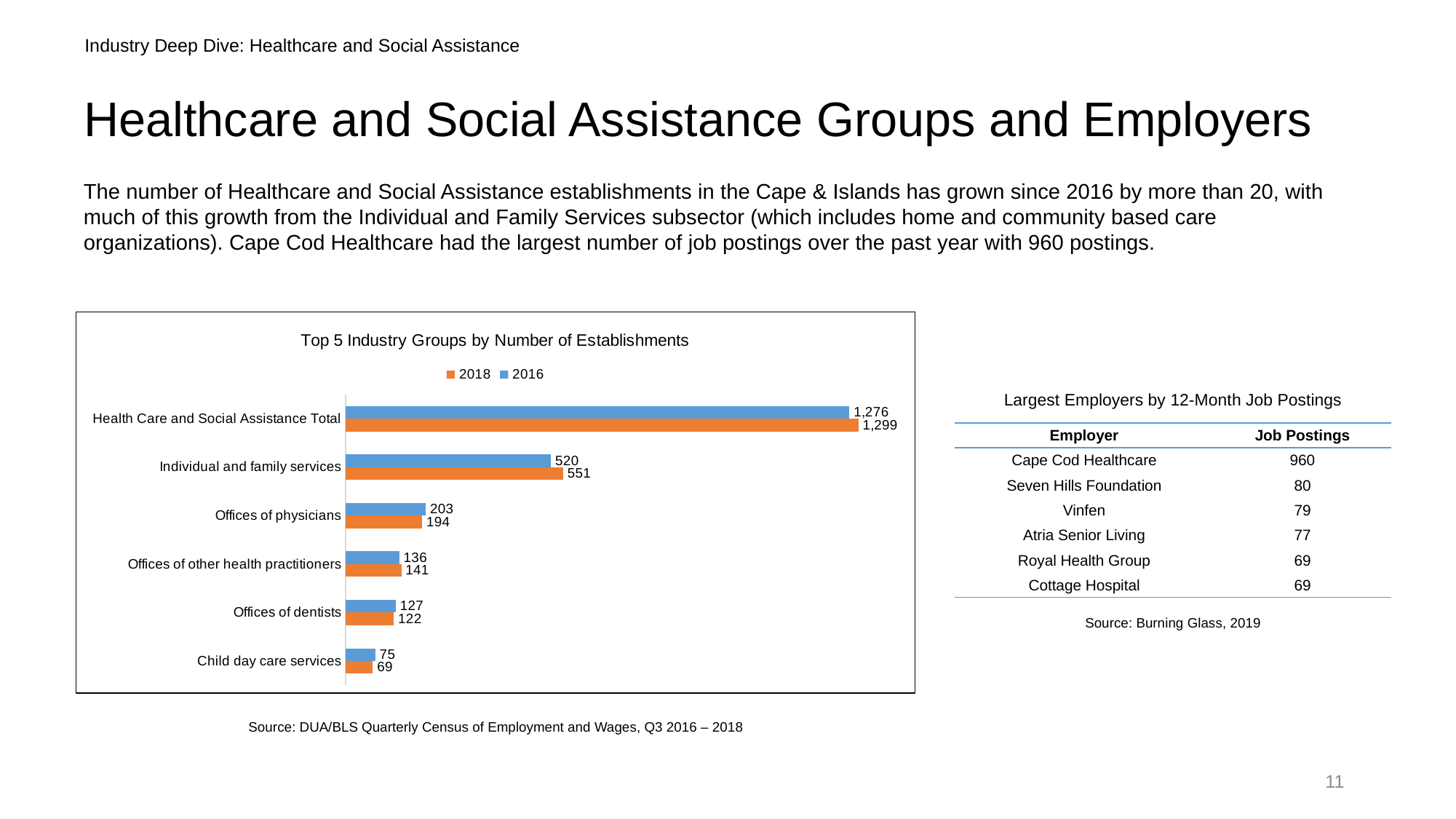
Excluding the total, which category has the highest number of establishments in 2016? Individual and family services Which colour represents the 2018 series in the chart? Orange What is the 2018 value for Individual and family services in the chart? 551 What is the difference between the 2018 and 2016 values for Individual and family services? 31 What is the 2016 value for Health Care and Social Assistance Total in the chart? 1,276 For Offices of dentists, which year has the larger value, 2016 or 2018? 2016 How many categories are shown on the Top 5 Industry Groups by Number of Establishments chart? 6 What is the 2018 value for Child day care services in the chart? 69 What type of chart is used for Top 5 Industry Groups by Number of Establishments? Bar chart What is the 2016 value for Offices of physicians in the chart? 203 Excluding the total, which category has the lowest number of establishments in 2018? Child day care services How many series does the legend of the Top 5 Industry Groups chart list? 2